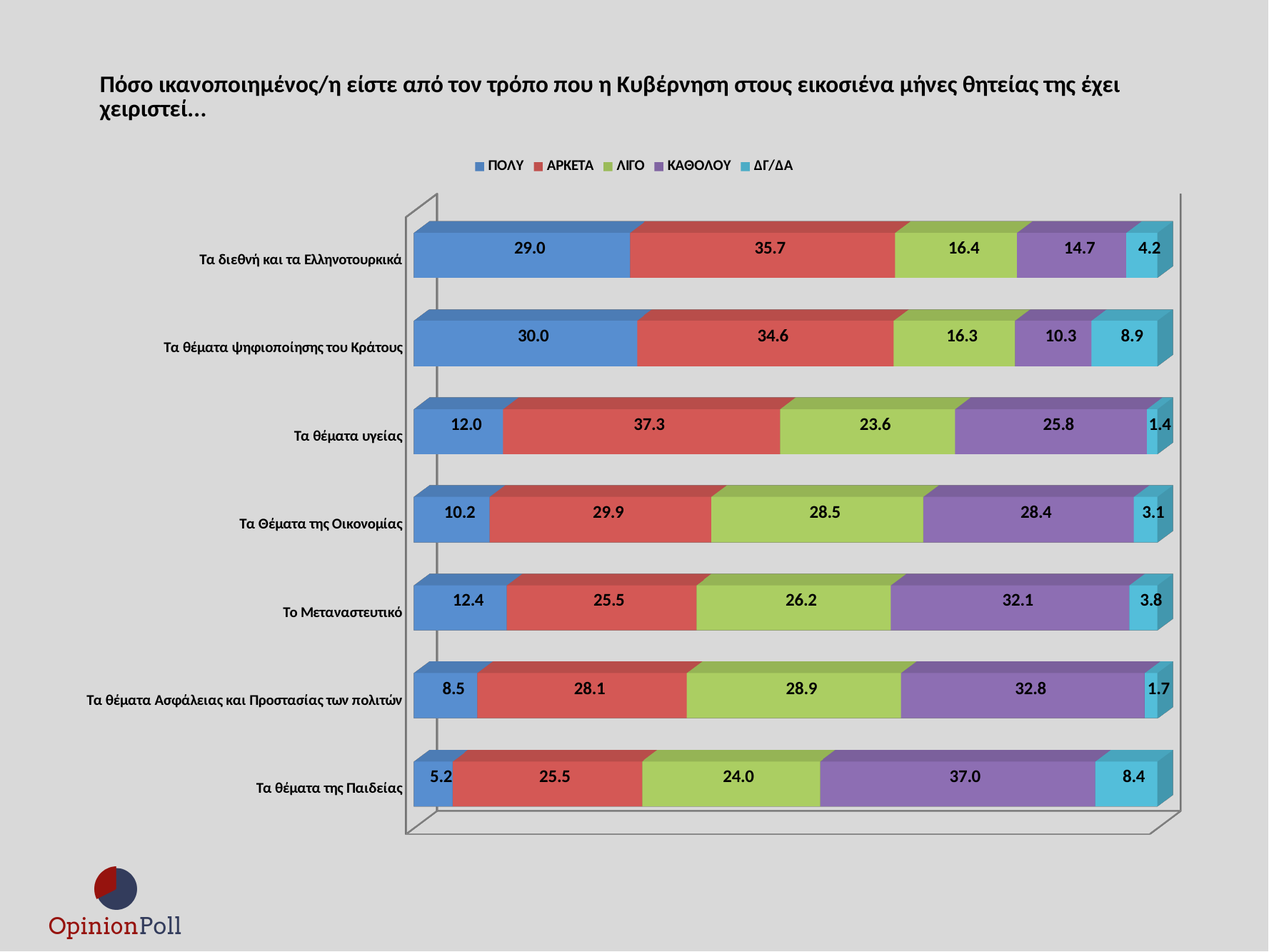
How many categories (topics) are plotted on the chart? 7 What is the difference between the ΑΡΚΕΤΑ and ΠΟΛΥ values for Τα διεθνή και τα Ελληνοτουρκικά? 6.7 Which is larger: the ΔΓ/ΔΑ value for Τα θέματα ψηφιοποίησης του Κράτους or for Τα θέματα της Παιδείας? Τα θέματα ψηφιοποίησης του Κράτους What is the ΚΑΘΟΛΟΥ value for Το Μεταναστευτικό? 32.1 Which category has the lowest ΠΟΛΥ value? Τα θέματα της Παιδείας What is the ΠΟΛΥ value for Τα θέματα υγείας? 12.0 What is the total of the stacked bar for Τα διεθνή και τα Ελληνοτουρκικά? 100.0 What kind of chart is shown on the slide? Stacked bar chart How many series does the legend list? 5 Which category has the highest ΠΟΛΥ value? Τα θέματα ψηφιοποίησης του Κράτους What is the ΔΓ/ΔΑ value for Τα θέματα ψηφιοποίησης του Κράτους? 8.9 Which category has the highest ΚΑΘΟΛΟΥ value? Τα θέματα της Παιδείας